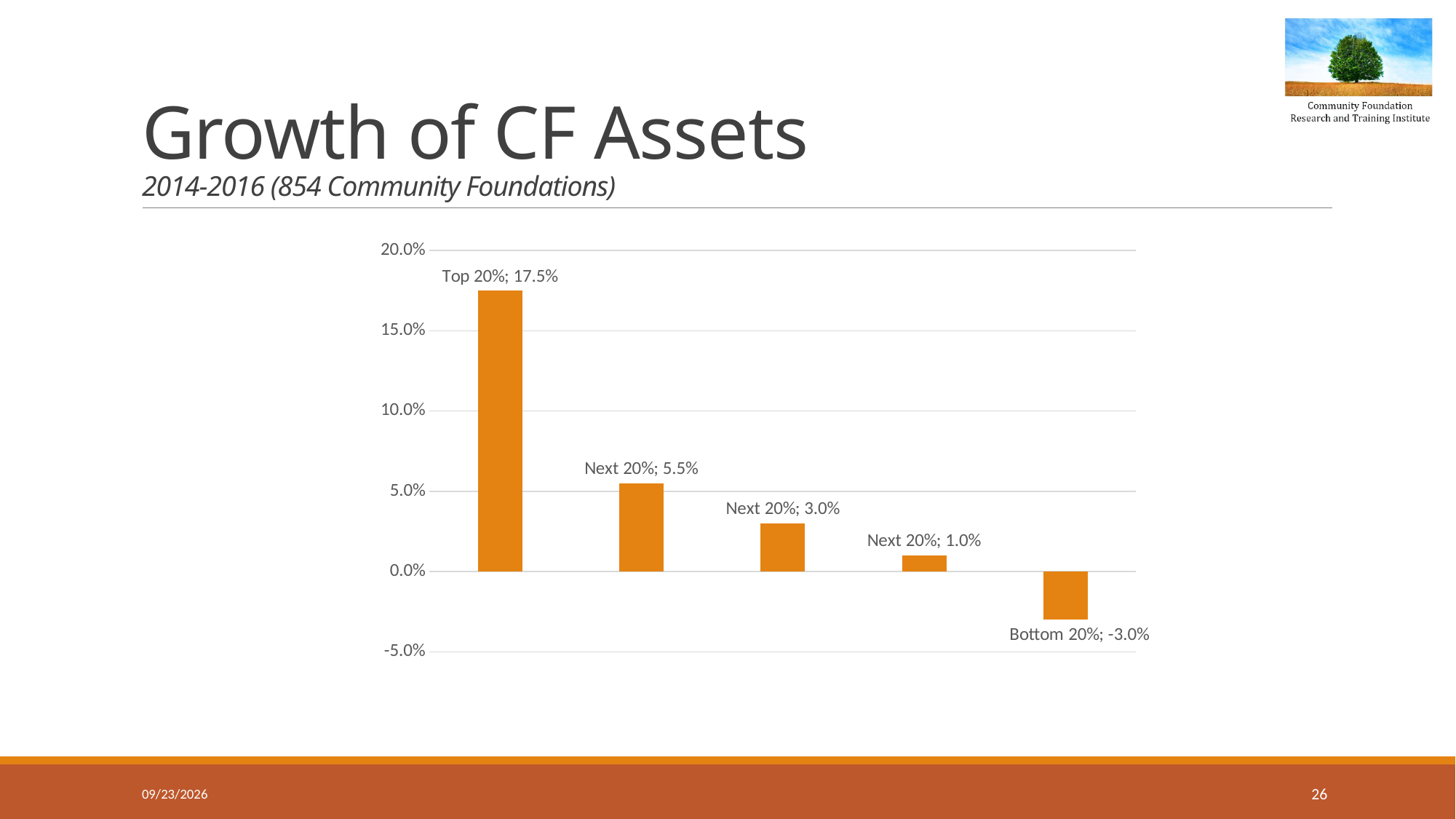
What kind of chart is shown on the slide? Bar chart Do the values rise or fall moving from left to right across the bars? Fall What is the difference between the second bar (5.5%) and the third bar (3.0%)? 2.5 percentage points What is the difference between the Top 20% value and the Bottom 20% value? 20.5 percentage points What is the value for the Top 20% bar? 17.5% How many bars are shown in the chart? 5 What is the value of the fourth bar from the left (the last 'Next 20%' bar)? 1.0% What is the value of the second bar from the left (the first 'Next 20%' bar)? 5.5% Which category has the lowest value? Bottom 20% Which is larger, the value for the Top 20% or the value of the second bar from the left? Top 20% What is the value for the Bottom 20% bar? -3.0% Which category has the highest value? Top 20%